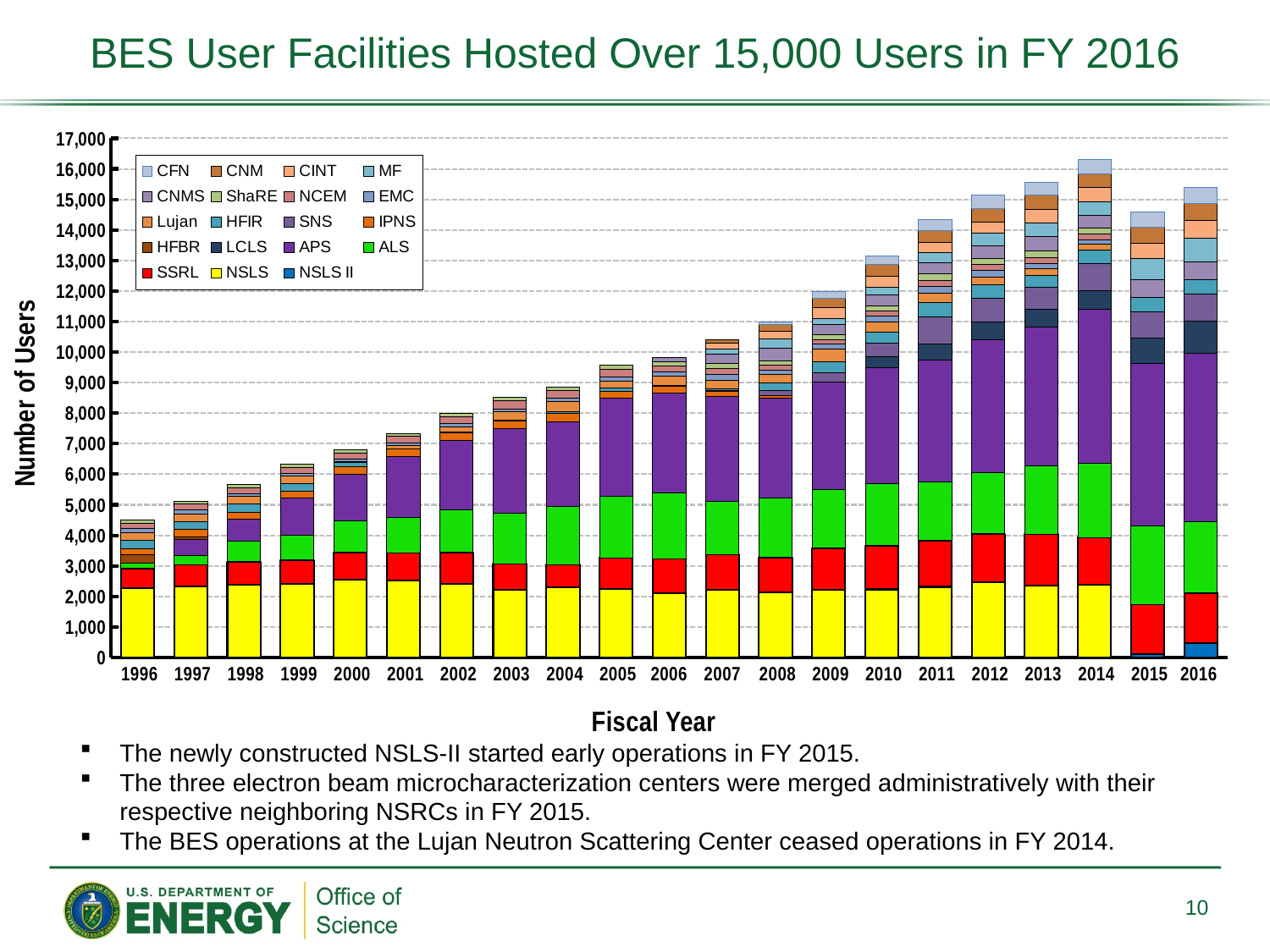
Is the total number of users in 1996 greater or less than 5,000? less Is the total number of users in 2016 greater or less than 15,000? greater How many fiscal years are shown along the x axis of the chart? 21 What is the label on the y axis of the chart? Number of Users Is the total number of users in 2014 greater or less than 16,000? greater Which fiscal year has the lowest total number of users? 1996 How many series does the chart's legend list? 19 What kind of chart is shown on the slide? Stacked bar chart Which fiscal year has a larger total number of users, 2015 or 2016? 2016 Which fiscal year has the highest total number of users? 2014 Overall, do the total number of users rise or fall from 1996 to 2014? rise